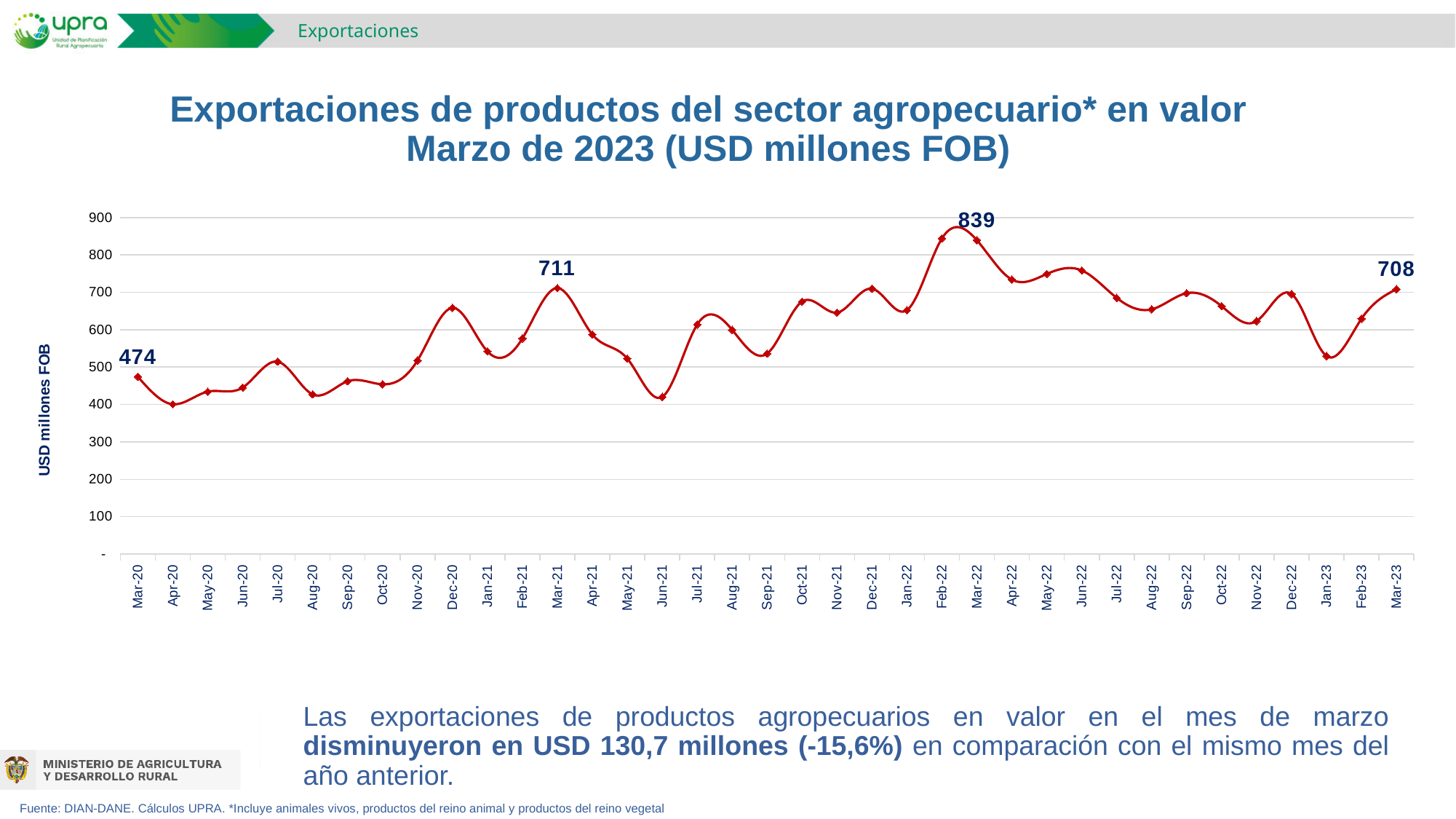
What was the value of agricultural exports in Mar-22? 839 What was the value of agricultural exports in Mar-21? 711 What is the difference between the export values of Mar-21 and Mar-20? 237 What was the value of agricultural exports in Mar-20? 474 What is the label of the vertical axis? USD millones FOB By how much did the export value in Mar-23 differ from Mar-22? 131 How many monthly data points are plotted on the chart? 37 What type of chart is shown on the slide? Line chart What was the value of agricultural exports in Mar-23? 708 Is the value for Dec-22 greater or less than 600? greater Which month had a higher export value, Mar-22 or Mar-23? Mar-22 Is the value for Jun-21 greater or less than 500? less